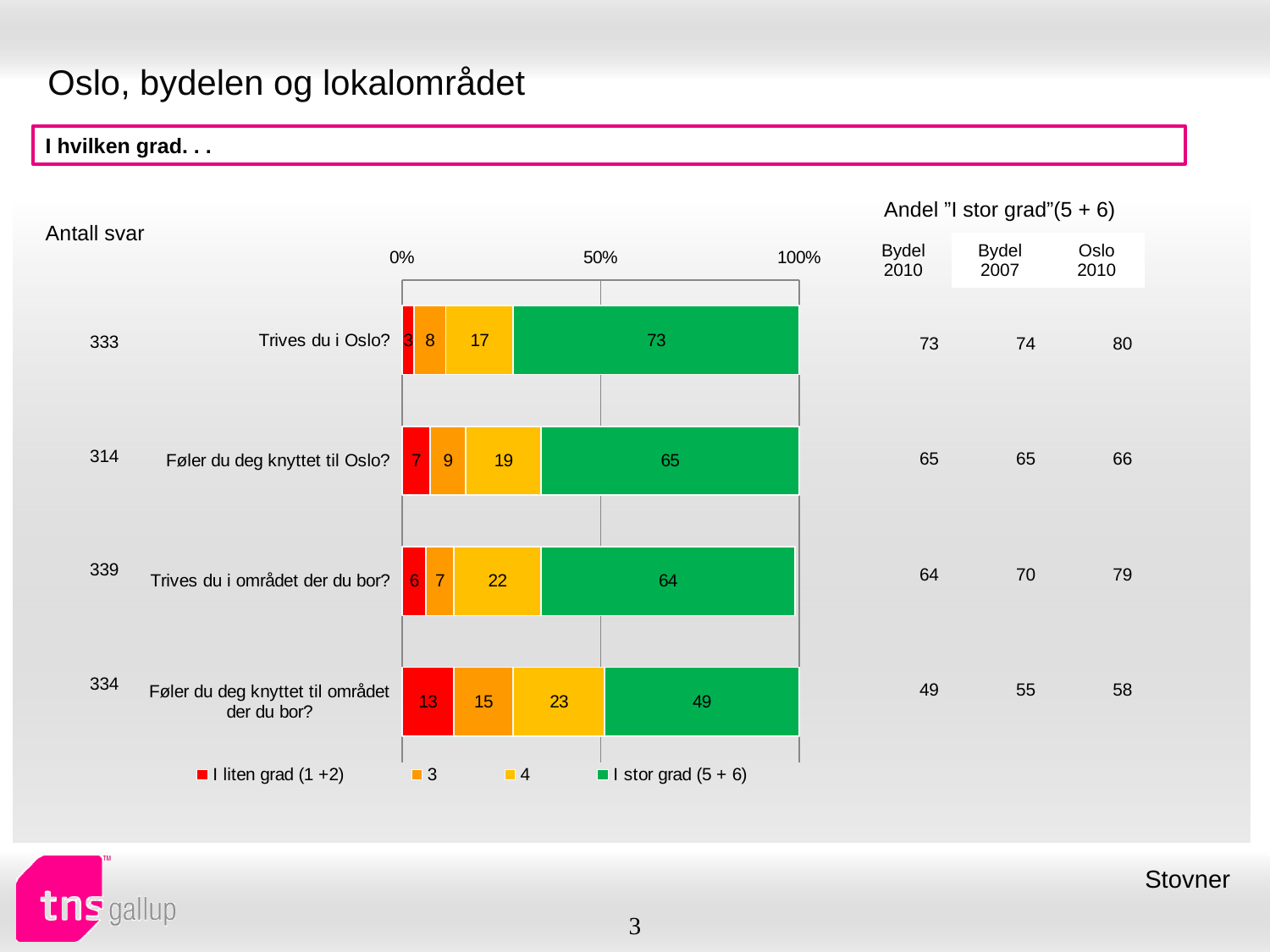
Which category has the lowest value for "I stor grad (5 + 6)"? Føler du deg knyttet til området der du bor? What is the value of series "4" for "Trives du i området der du bor?"? 22 How many series does the legend list? 4 How many categories (questions) are plotted in the chart? 4 What is the total of the stacked bar for "Føler du deg knyttet til Oslo?"? 100 Which is larger: the "I liten grad (1 +2)" value for "Føler du deg knyttet til Oslo?" or for "Trives du i området der du bor?"? Føler du deg knyttet til Oslo? What kind of chart is shown on the slide? bar chart What is the value of "I stor grad (5 + 6)" for "Trives du i Oslo?"? 73 What is the difference between the "I stor grad (5 + 6)" values for "Trives du i Oslo?" and "Føler du deg knyttet til området der du bor?"? 24 What is the value of "I liten grad (1 +2)" for "Føler du deg knyttet til området der du bor?"? 13 What is the value of series "3" for "Føler du deg knyttet til Oslo?"? 9 Which category has the highest value for "I stor grad (5 + 6)"? Trives du i Oslo?